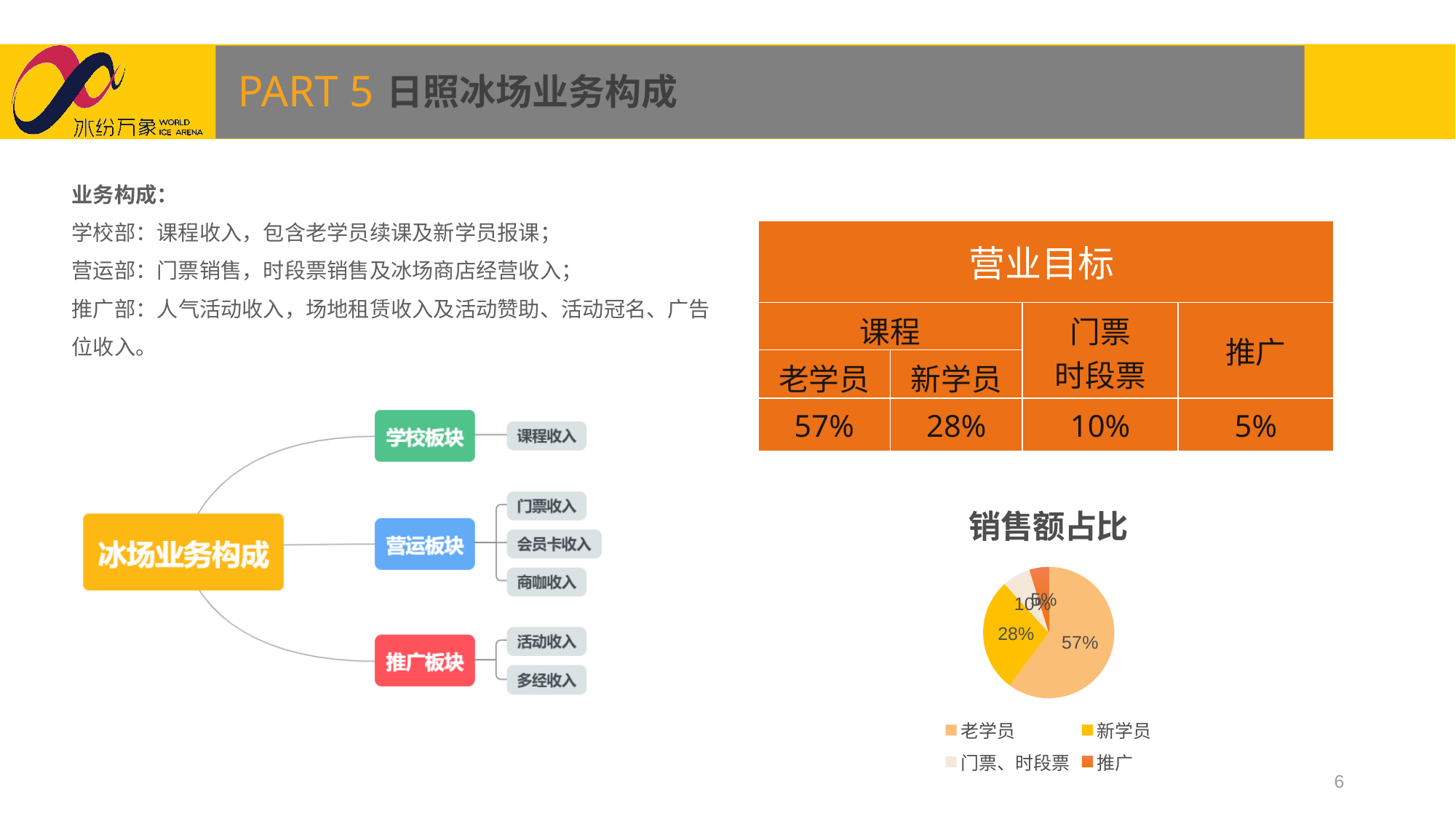
Which slice of the "销售额占比" pie chart is the largest? 老学员 What type of chart is the "销售额占比" chart? pie chart How many slices does the "销售额占比" pie chart have? 4 In the "销售额占比" pie chart, which is larger, 新学员 or 门票、时段票? 新学员 Which slice of the "销售额占比" pie chart is the smallest? 推广 In the "销售额占比" pie chart, what share does 推广 have? 5% How many entries does the legend of the "销售额占比" pie chart list? 4 What is the title of the pie chart on the slide? 销售额占比 In the "销售额占比" pie chart, what is the difference between the 老学员 share and the 新学员 share? 29% In the "销售额占比" pie chart, what share does 新学员 have? 28% In the "销售额占比" pie chart, what share does 门票、时段票 have? 10% In the "销售额占比" pie chart, what share does 老学员 have? 57%